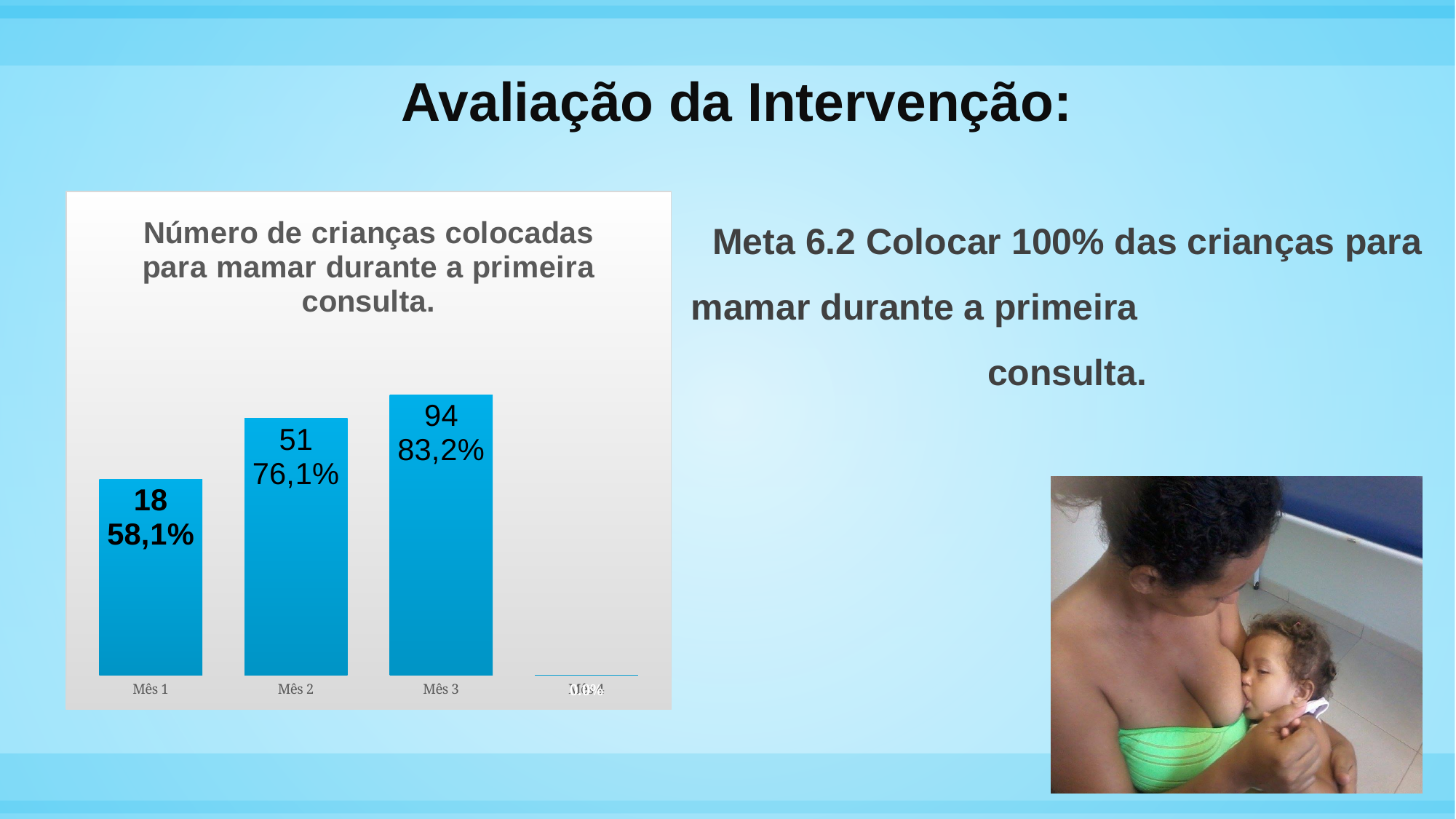
What type of chart is shown on the slide? bar chart Which month has the highest number of children? Mês 3 What is the title of the chart? Número de crianças colocadas para mamar durante a primeira consulta. What percentage is shown for Mês 1? 58,1% What percentage is shown for Mês 2? 76,1% What percentage is shown for Mês 3? 83,2% What is the difference in the number of children between Mês 3 and Mês 1? 76 What is the number of children for Mês 1? 18 Do the values rise or fall from Mês 1 to Mês 3? rise What is the number of children for Mês 2? 51 What is the number of children for Mês 3? 94